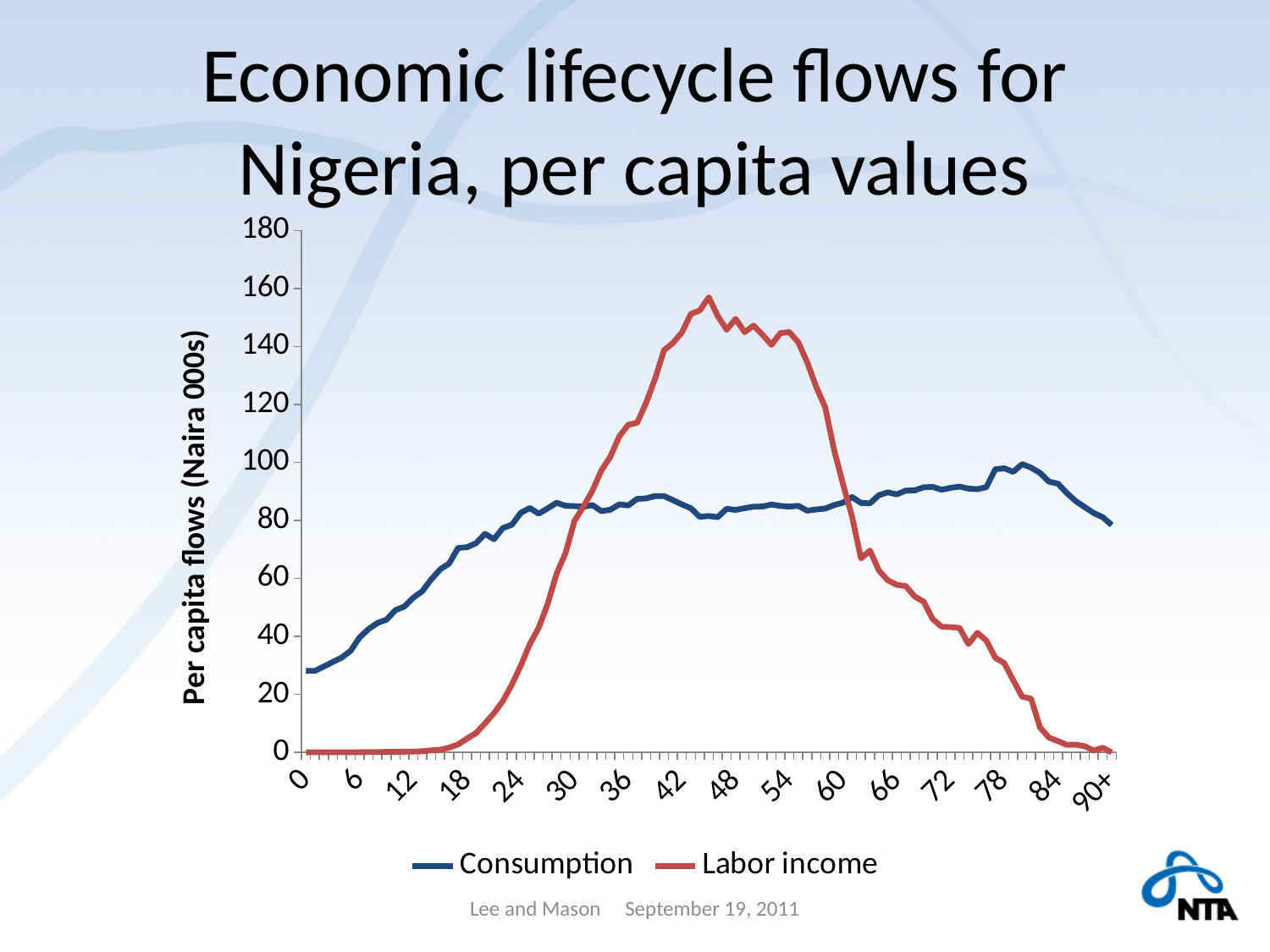
Which colour is used for the Labor income line? Red Is the value of Consumption at age 78 greater or less than 80? greater What kind of chart is shown on the slide? Line chart Is the value of Labor income at age 66 greater or less than 80? less Is the value of Labor income at age 45 greater or less than 140? greater At age 6, which series has the higher value, Consumption or Labor income? Consumption How many series does the legend list? 2 Does the Labor income line rise or fall between age 48 and age 84? Fall What is the title of the vertical axis? Per capita flows (Naira 000s) At age 45, which series has the higher value, Consumption or Labor income? Labor income